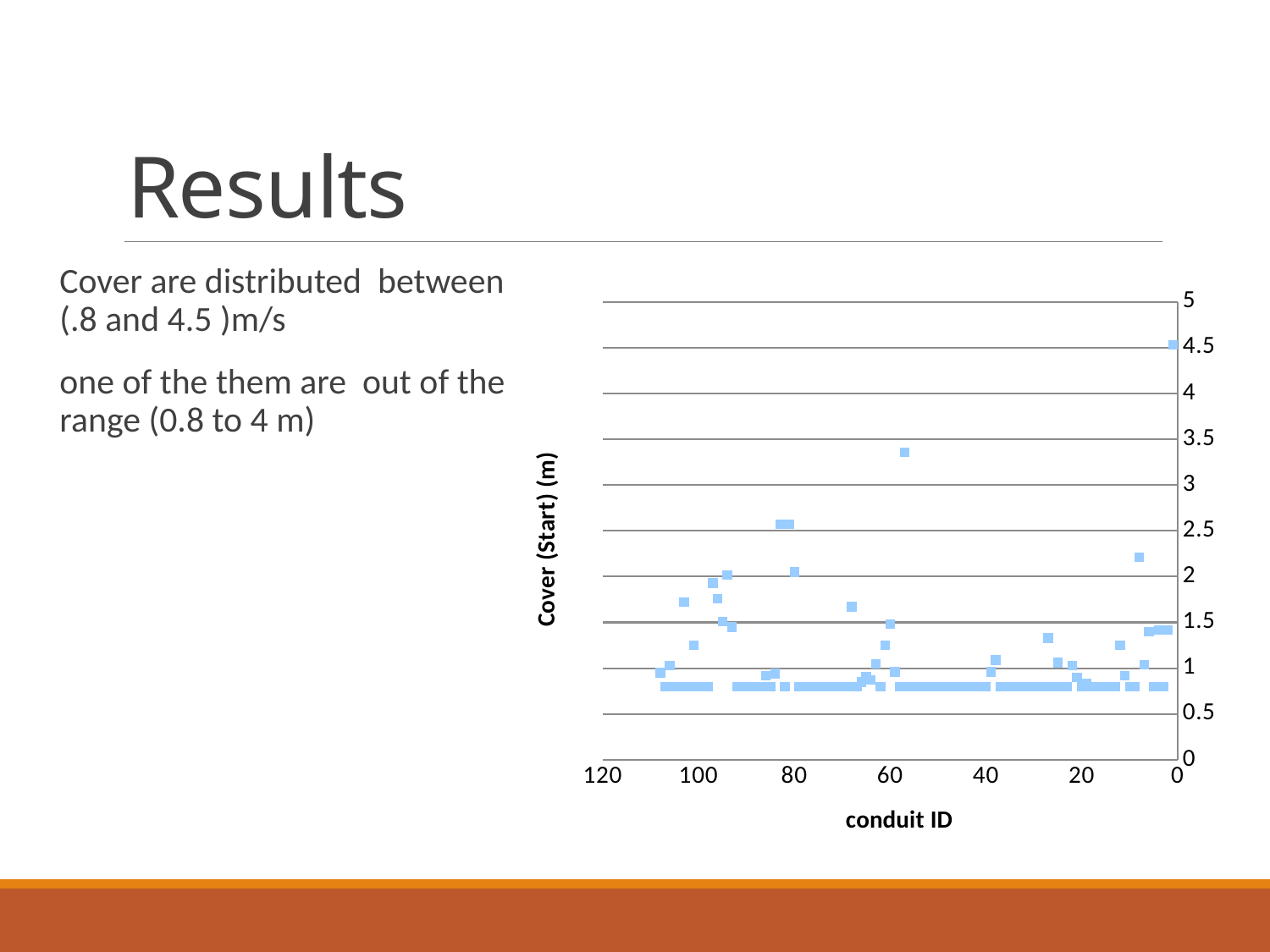
Is the cover value plotted near conduit ID 57 greater or less than 3? greater Is the cover value plotted near conduit ID 7 greater or less than 2? greater Is the cover value plotted near conduit ID 57 greater or less than 3.5? less What is the title of the horizontal axis of the chart? conduit ID Is the cover value plotted near conduit ID 57 larger or smaller than the value plotted near conduit ID 7? larger What kind of chart is shown on the slide? scatter chart What is the title of the vertical axis of the chart? Cover (Start) (m)